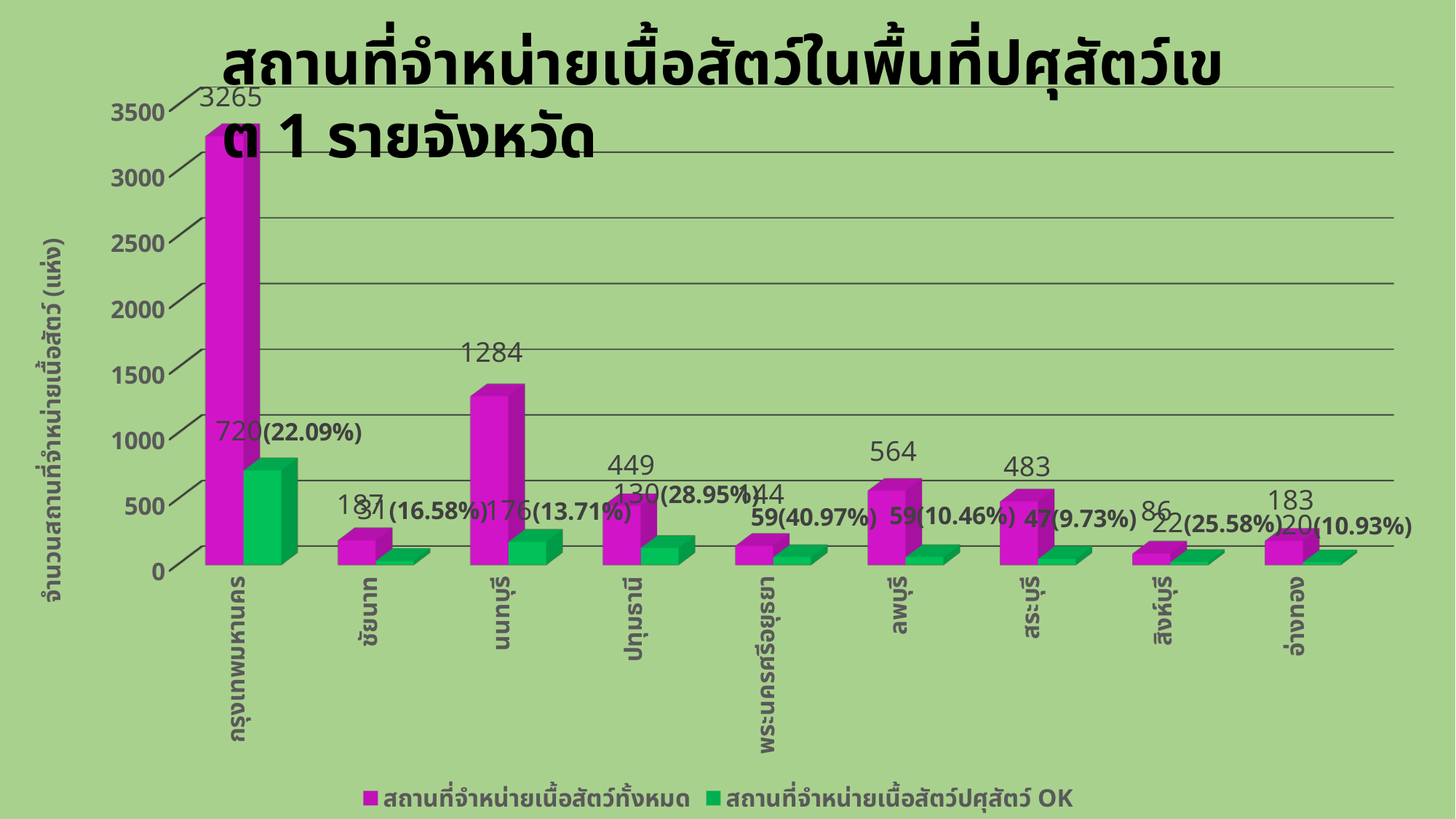
What is the value of สถานที่จำหน่ายเนื้อสัตว์ทั้งหมด for สิงห์บุรี? 86 Is the value of สถานที่จำหน่ายเนื้อสัตว์ทั้งหมด for ปทุมธานี greater or less than 500? less How many series does the legend list? 2 What is the value of สถานที่จำหน่ายเนื้อสัตว์ทั้งหมด for กรุงเทพมหานคร? 3265 Which province has the lowest value of สถานที่จำหน่ายเนื้อสัตว์ทั้งหมด? สิงห์บุรี What kind of chart is shown on the slide? bar chart What is the difference between the สถานที่จำหน่ายเนื้อสัตว์ทั้งหมด values for กรุงเทพมหานคร and นนทบุรี? 1981 Which has a larger value of สถานที่จำหน่ายเนื้อสัตว์ทั้งหมด, ลพบุรี or สระบุรี? ลพบุรี What is the data label for สถานที่จำหน่ายเนื้อสัตว์ปศุสัตว์ OK for ปทุมธานี? 130(28.95%) What is the value of สถานที่จำหน่ายเนื้อสัตว์ทั้งหมด for นนทบุรี? 1284 Which province has the highest value of สถานที่จำหน่ายเนื้อสัตว์ทั้งหมด? กรุงเทพมหานคร How many provinces (categories) are shown on the x axis? 9